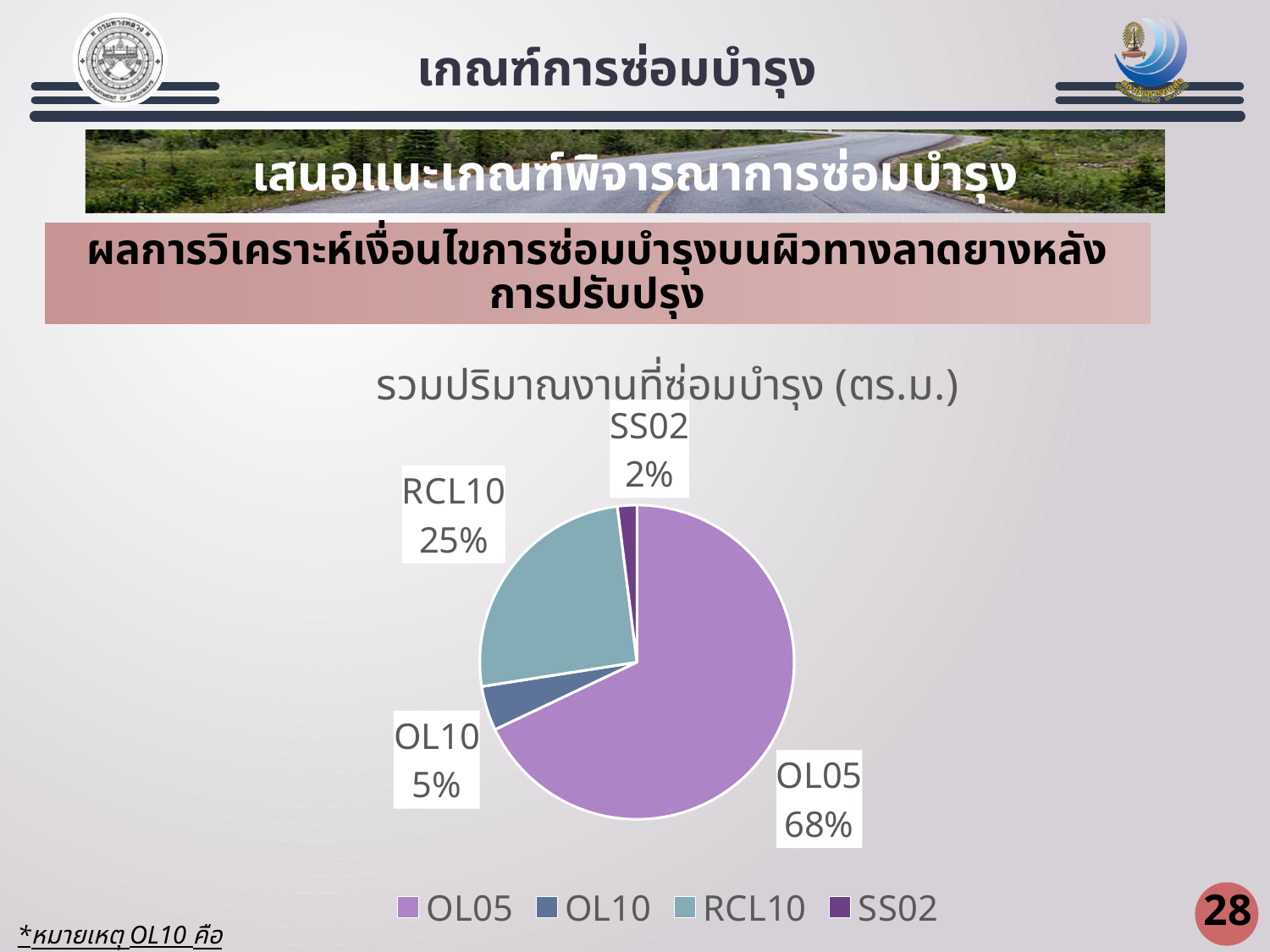
What share of the pie does SS02 have? 2% What share of the pie does OL05 have? 68% Which is larger, the share for OL10 or the share for RCL10? RCL10 How many slices does the pie chart have? 4 What is the difference in percentage points between OL05 and RCL10? 43 What is the title of the pie chart? รวมปริมาณงานที่ซ่อมบำรุง (ตร.ม.) What share of the pie does OL10 have? 5% What kind of chart is shown on the slide? pie chart Which category has the largest slice of the pie? OL05 How many entries does the legend list? 4 Which category has the smallest slice of the pie? SS02